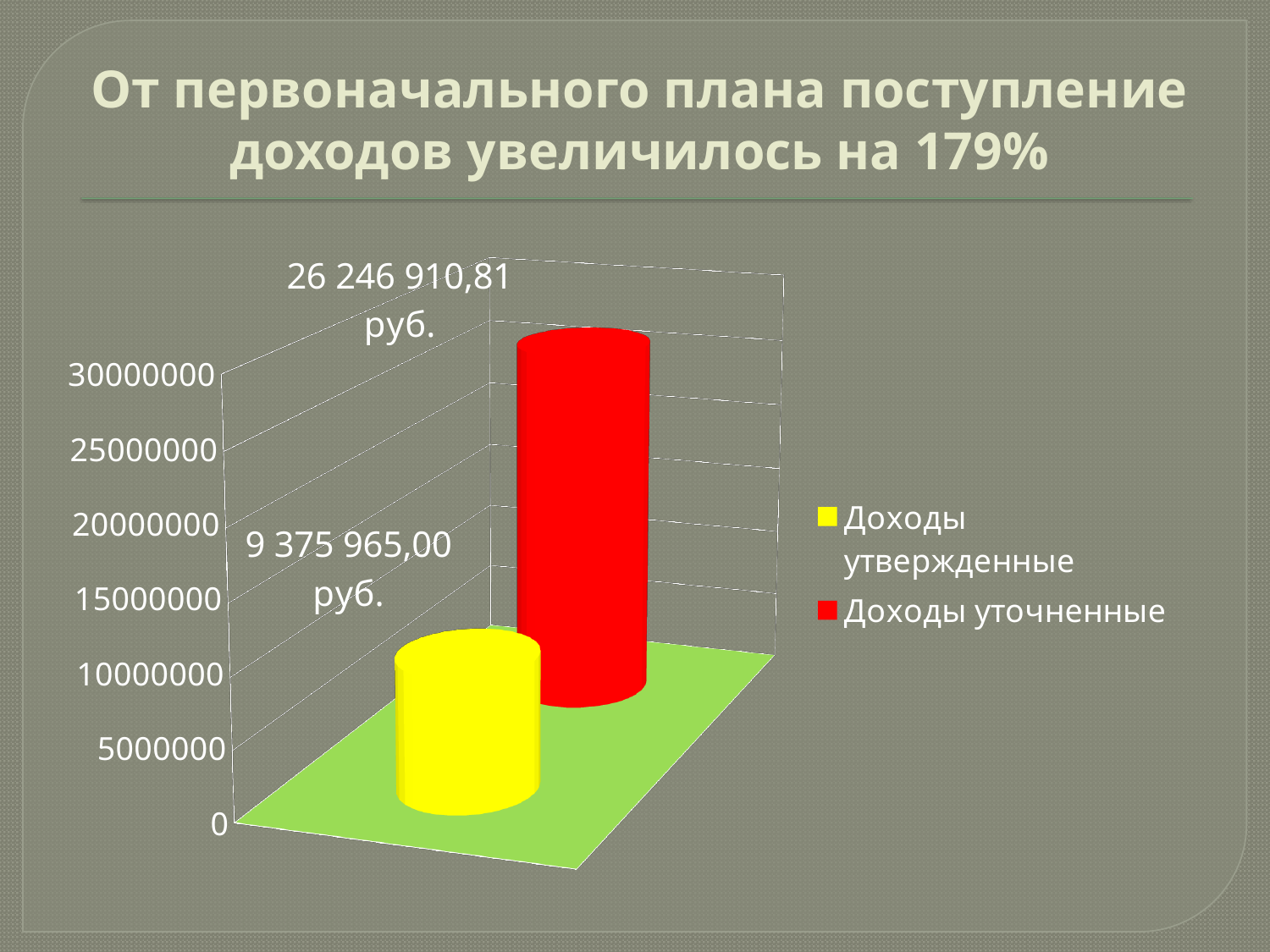
Is the value for Доходы уточненные greater or less than 25000000? greater Which series has the highest value on the chart? Доходы уточненные Which series has the lowest value on the chart? Доходы утвержденные What is the difference between the value for Доходы уточненные and the value for Доходы утвержденные? 16 870 945,81 руб. What is the title of the slide? От первоначального плана поступление доходов увеличилось на 179% Is the value for Доходы утвержденные greater or less than 10000000? less What kind of chart is shown on the slide? bar chart What is the value shown for Доходы утвержденные? 9 375 965,00 руб. Which series has the higher value, Доходы утвержденные or Доходы уточненные? Доходы уточненные How many series does the legend list? 2 What colour is the bar for Доходы уточненные? red What is the value shown for Доходы уточненные? 26 246 910,81 руб.